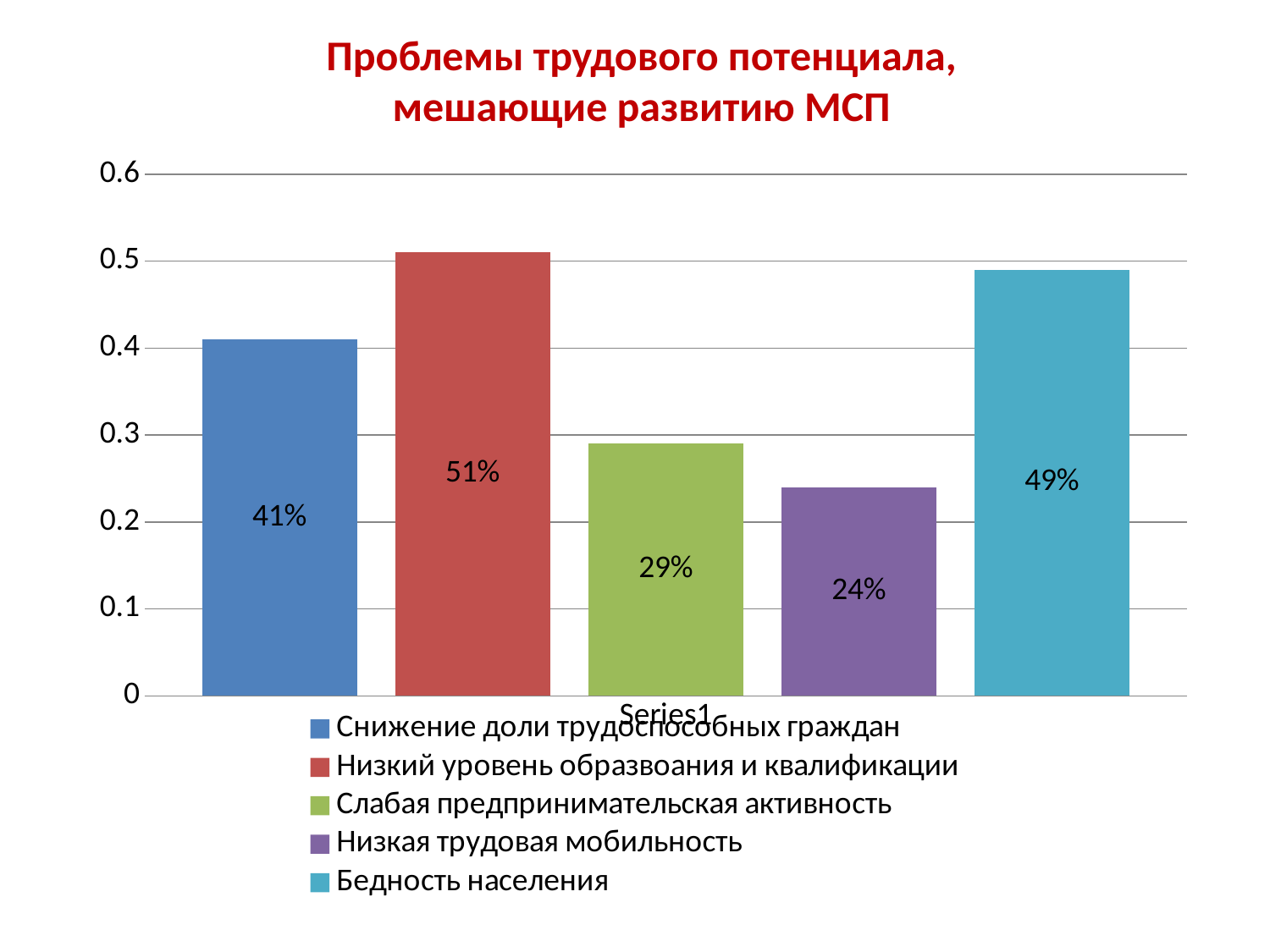
How many bars are plotted on the chart? 5 Which is larger: the value for «Снижение доли трудоспособных граждан» or for «Бедность населения»? Бедность населения What is the difference between the values for «Низкий уровень образвоания и квалификации» and «Низкая трудовая мобильность»? 27% Which problem has the lowest value on the chart? Низкая трудовая мобильность What kind of chart is shown on the slide? Bar chart Which problem has the highest value on the chart? Низкий уровень образвоания и квалификации How many entries does the legend list? 5 What value is shown for «Низкая трудовая мобильность»? 24% What value is shown for «Бедность населения»? 49% What value is shown for «Снижение доли трудоспособных граждан»? 41% What value is shown for «Низкий уровень образвоания и квалификации»? 51% What value is shown for «Слабая предпринимательская активность»? 29%